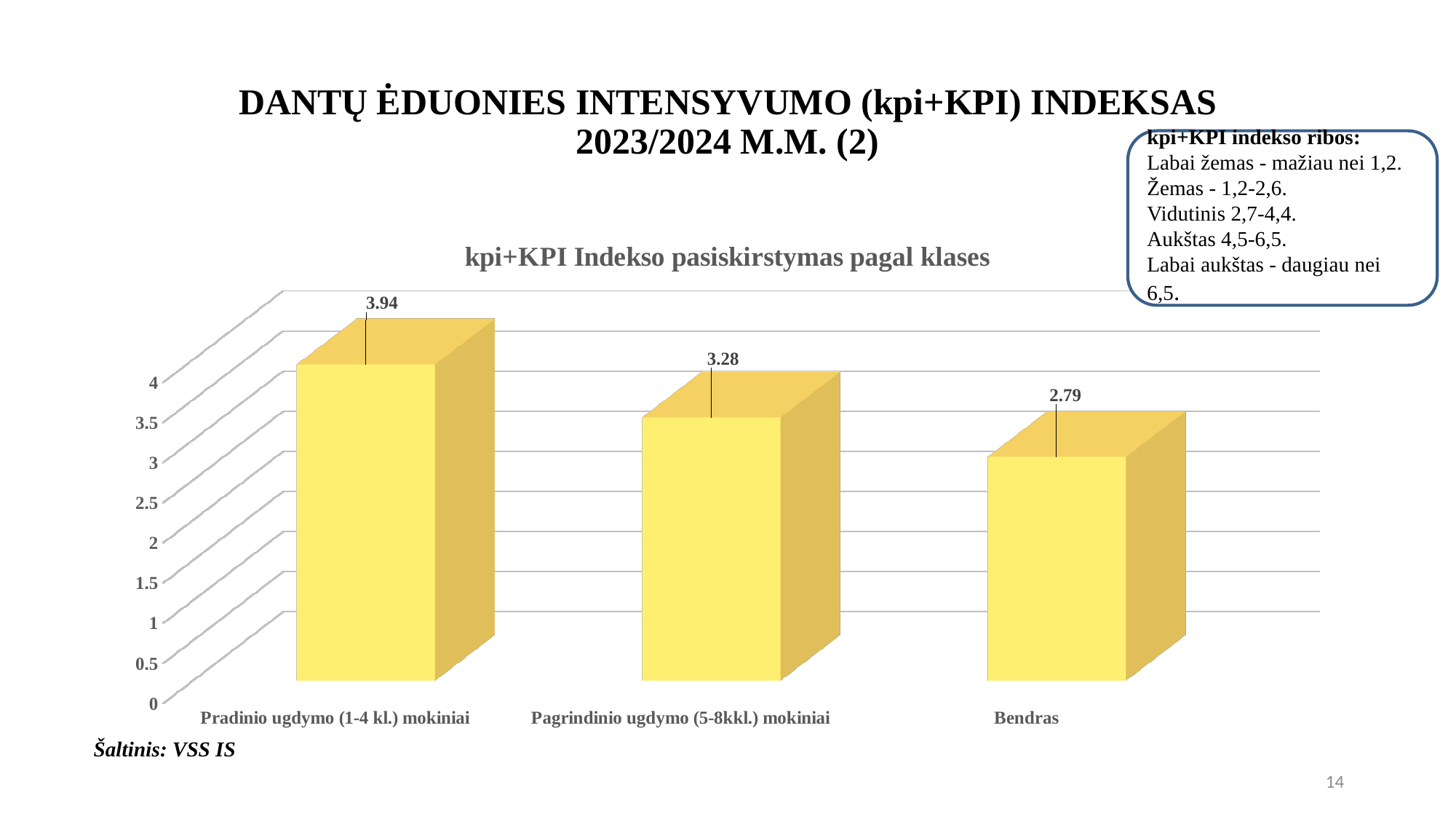
What is the difference between the values for Pradinio ugdymo (1-4 kl.) mokiniai and Bendras? 1.15 Which is larger, the value for Pagrindinio ugdymo (5-8kkl.) mokiniai or the value for Bendras? Pagrindinio ugdymo (5-8kkl.) mokiniai What is the value for Bendras? 2.79 Which category has the lowest value? Bendras What is the title of the chart? kpi+KPI Indekso pasiskirstymas pagal klases Which category has the highest value? Pradinio ugdymo (1-4 kl.) mokiniai How many categories are shown in the chart? 3 Is the value for Bendras greater or less than 3? less What is the value for Pradinio ugdymo (1-4 kl.) mokiniai? 3.94 What is the difference between the values for Pradinio ugdymo (1-4 kl.) mokiniai and Pagrindinio ugdymo (5-8kkl.) mokiniai? 0.66 What is the value for Pagrindinio ugdymo (5-8kkl.) mokiniai? 3.28 What kind of chart is shown on the slide? bar chart